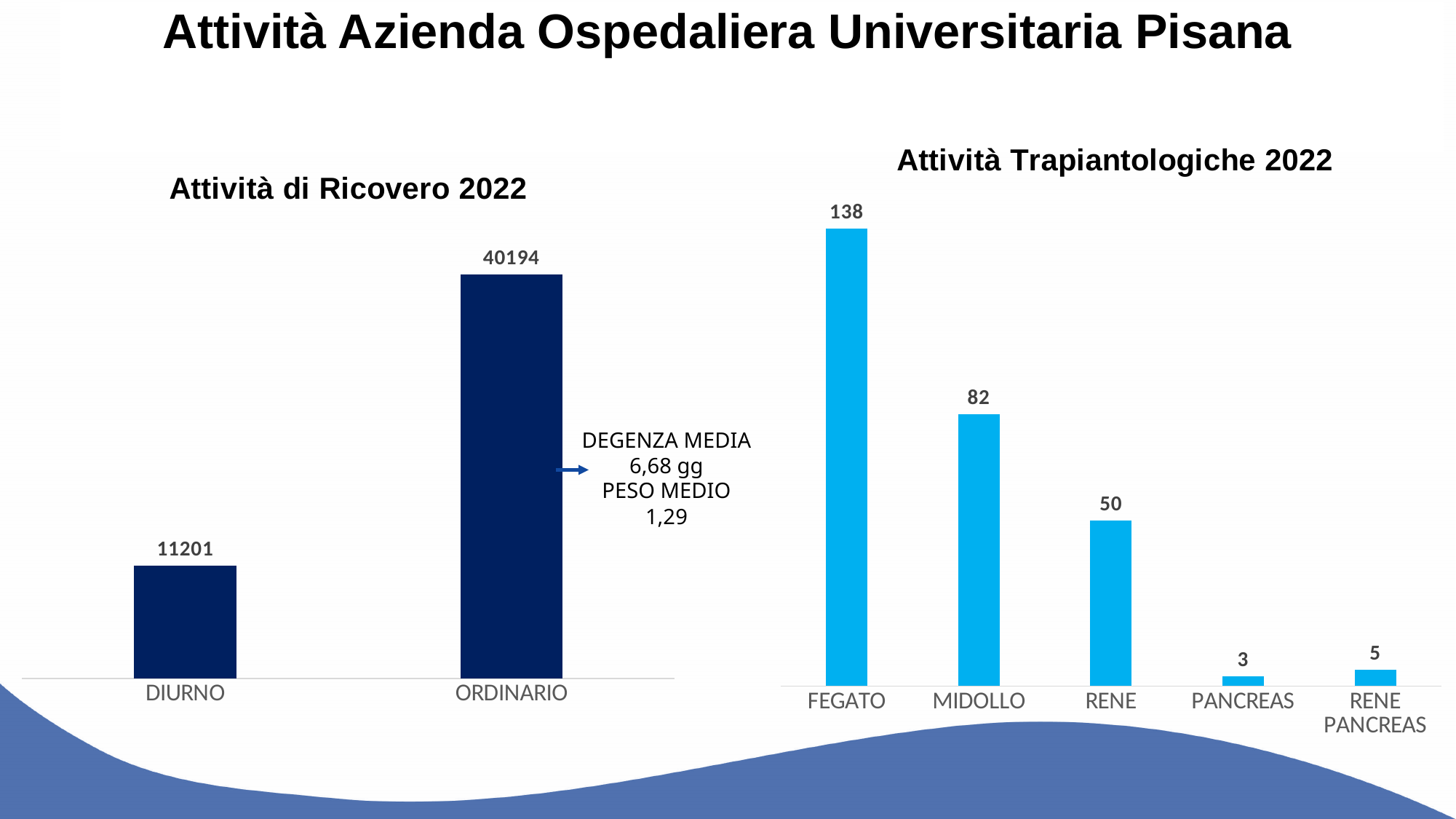
In the 'Attività Trapiantologiche 2022' chart, how many categories are shown? 5 In the 'Attività di Ricovero 2022' chart, what is the difference between ORDINARIO and DIURNO? 28993 In the 'Attività Trapiantologiche 2022' chart, which is larger, RENE or RENE PANCREAS? RENE In the 'Attività Trapiantologiche 2022' chart, which category has the highest value? FEGATO In the 'Attività di Ricovero 2022' chart, what is the value for ORDINARIO? 40194 In the 'Attività Trapiantologiche 2022' chart, what is the value for MIDOLLO? 82 In the 'Attività di Ricovero 2022' chart, how many categories are shown? 2 In the 'Attività Trapiantologiche 2022' chart, what is the difference between FEGATO and RENE? 88 In the 'Attività di Ricovero 2022' chart, what is the value for DIURNO? 11201 What kind of chart is the 'Attività Trapiantologiche 2022' chart? Bar chart In the 'Attività Trapiantologiche 2022' chart, which category has the lowest value? PANCREAS In the 'Attività Trapiantologiche 2022' chart, what is the value for FEGATO? 138